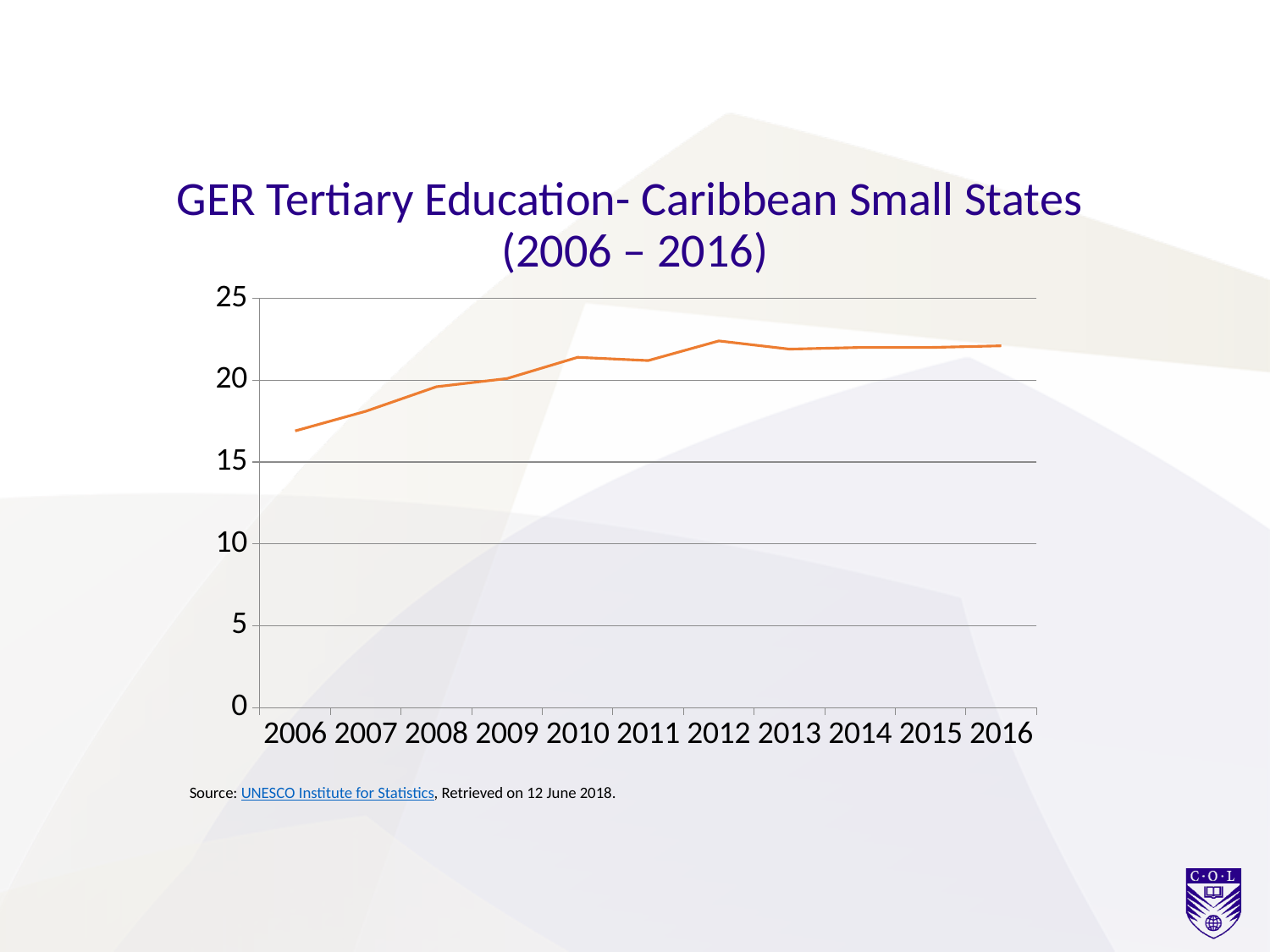
Is the value for 2006 greater or less than 20? less How many years are plotted along the x axis? 11 Is the value for 2006 greater or less than 15? greater Is the value for 2012 greater or less than 20? greater What is the title of the chart? GER Tertiary Education- Caribbean Small States (2006 – 2016) What kind of chart is shown on the slide? line chart Which is larger, the value for 2006 or the value for 2016? 2016 Which is larger, the value for 2008 or the value for 2012? 2012 Do the values generally rise or fall from 2006 to 2016? rise Which year has the lowest value? 2006